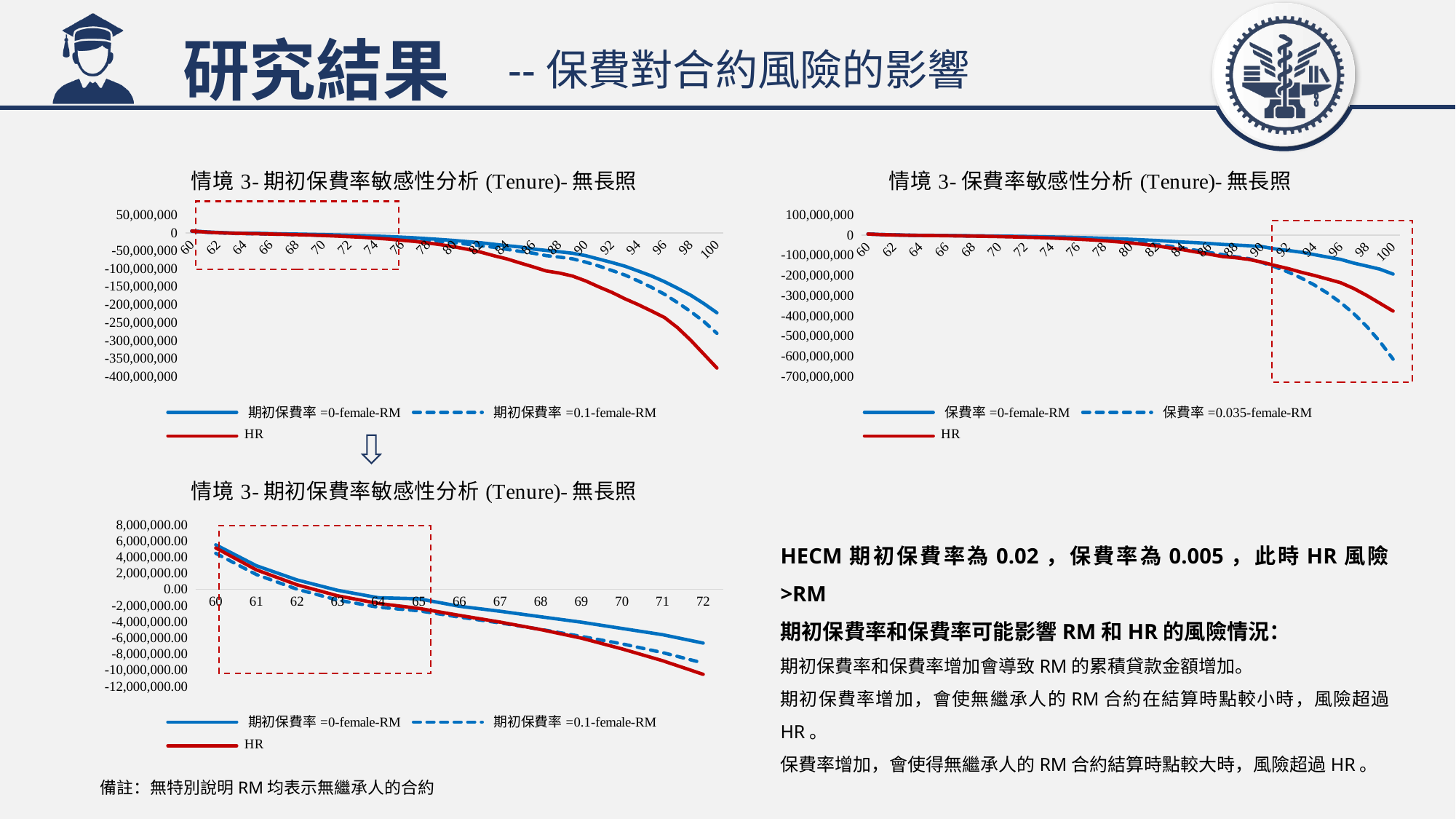
In the top-left chart (ages 60 to 100), is the value of 期初保費率 =0-female-RM at age 100 greater or less than -250,000,000? greater What kind of chart is the top-left chart titled 情境 3- 期初保費率敏感性分析 (Tenure)- 無長照? Line chart In the top-left chart (ages 60 to 100), which series has the lowest value at age 100? HR In the top-right chart (情境 3- 保費率敏感性分析 (Tenure)- 無長照), which series has the lowest value at age 100? 保費率 =0.035-female-RM In the bottom-left chart (ages 60 to 72), do the values rise or fall as age increases? Fall In the top-right chart (情境 3- 保費率敏感性分析 (Tenure)- 無長照), at age 100, which is larger: 保費率 =0-female-RM or HR? 保費率 =0-female-RM In the top-left chart (ages 60 to 100), is the value of HR at age 100 greater or less than -300,000,000? less In the bottom-left chart (ages 60 to 72), is the value of HR at age 72 greater or less than -8,000,000.00? less How many age ticks are shown on the x axis of the bottom-left chart (ages 60 to 72)? 13 How many series does the legend of the top-right chart (情境 3- 保費率敏感性分析 (Tenure)- 無長照) list? 3 In the bottom-left chart (ages 60 to 72), which series has the lowest value at age 72? HR